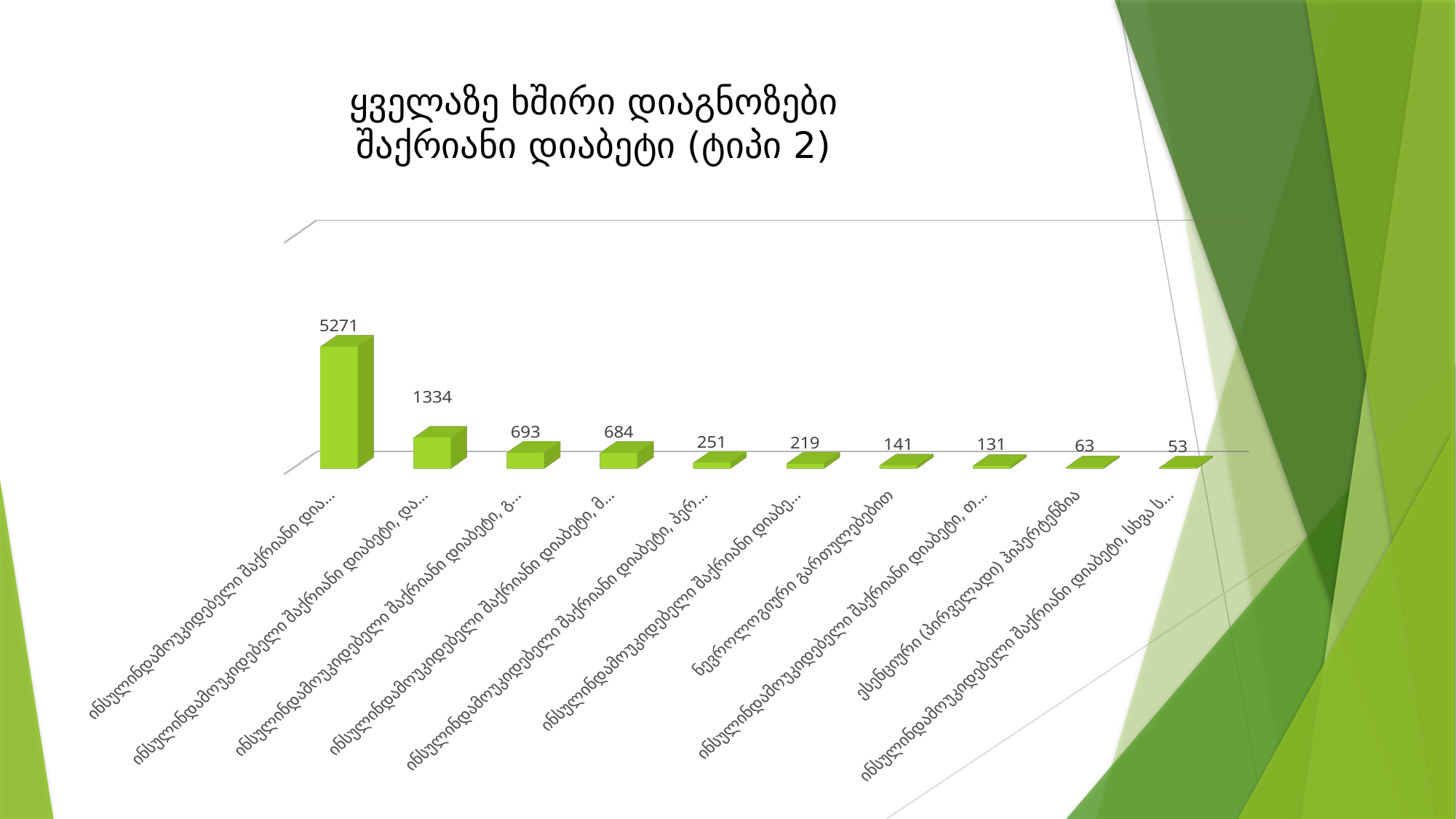
What is the value for the category labelled "ესენციური (პირველადი) ჰიპერტენზია"? 63 What is the title of the slide containing the chart? ყველაზე ხშირი დიაგნოზები შაქრიანი დიაბეტი (ტიპი 2) Do the bar values rise or fall from left to right across the chart? fall What is the value for the category labelled "ნევროლოგიური გართულებებით"? 141 How many bars (categories) does the chart show? 10 What is the value of the second bar from the left? 1334 What type of chart is shown on the slide? bar chart Which is larger: the fifth bar from the left or the sixth bar from the left? the fifth bar (251) What is the difference between the third bar (693) and the fourth bar (684)? 9 What is the value of the tallest bar in the chart? 5271 What is the difference between the first bar (5271) and the second bar (1334)? 3937 What is the value of the smallest bar in the chart? 53